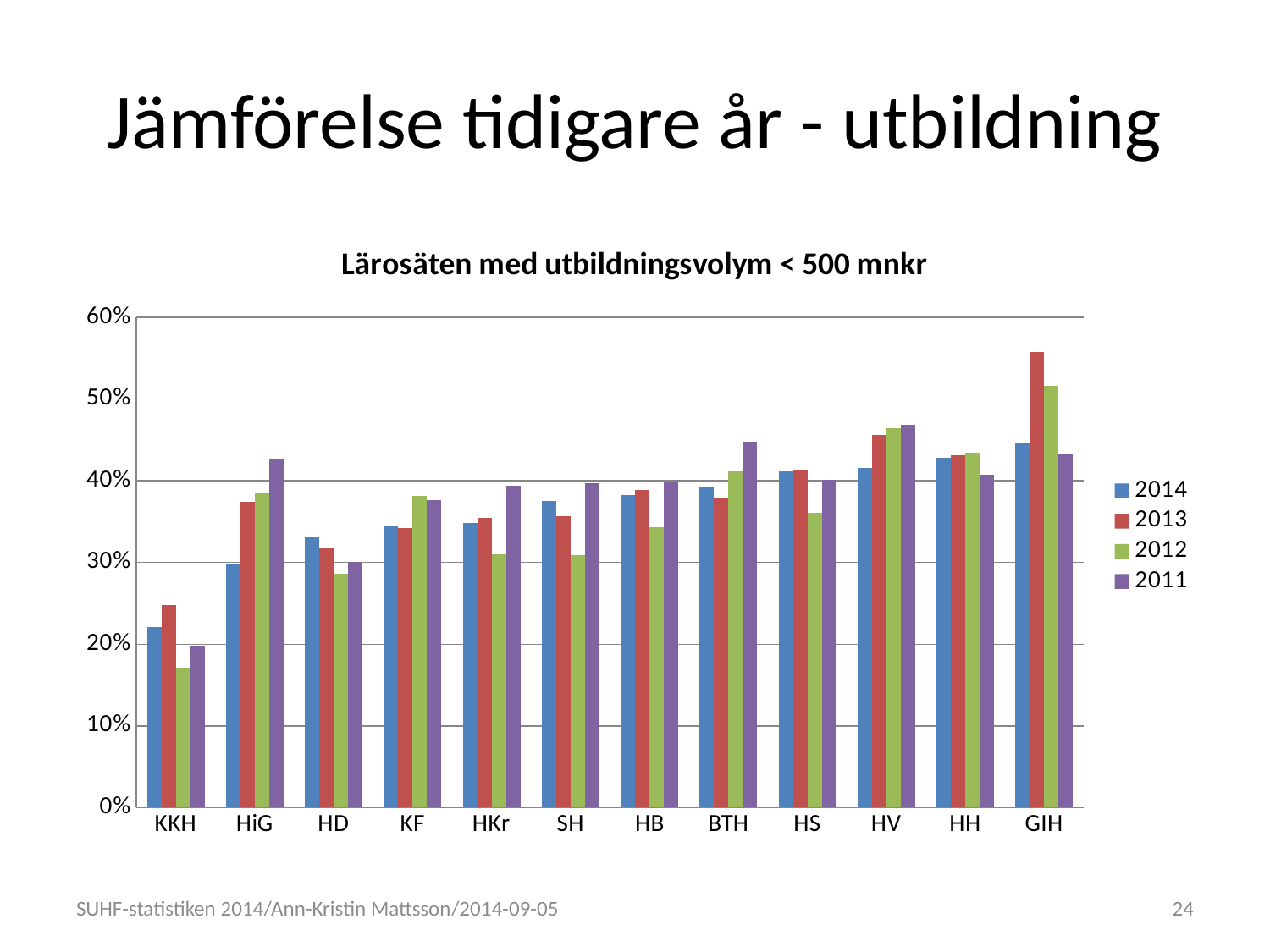
For HiG, which is larger: the 2014 value or the 2011 value? 2011 For KKH, which is larger: the 2013 value or the 2014 value? 2013 How many categories (lärosäten) are shown on the x axis? 12 What is the title of the chart? Lärosäten med utbildningsvolym < 500 mnkr Is the value for BTH in 2011 greater or less than 40%? greater What kind of chart is shown on the slide? bar chart Is the value for HD in 2012 greater or less than 30%? less Is the value for KKH in 2012 greater or less than 20%? less Which category has the lowest value for the 2014 series? KKH How many series does the legend list? 4 Which category has the highest value for the 2013 series? GIH